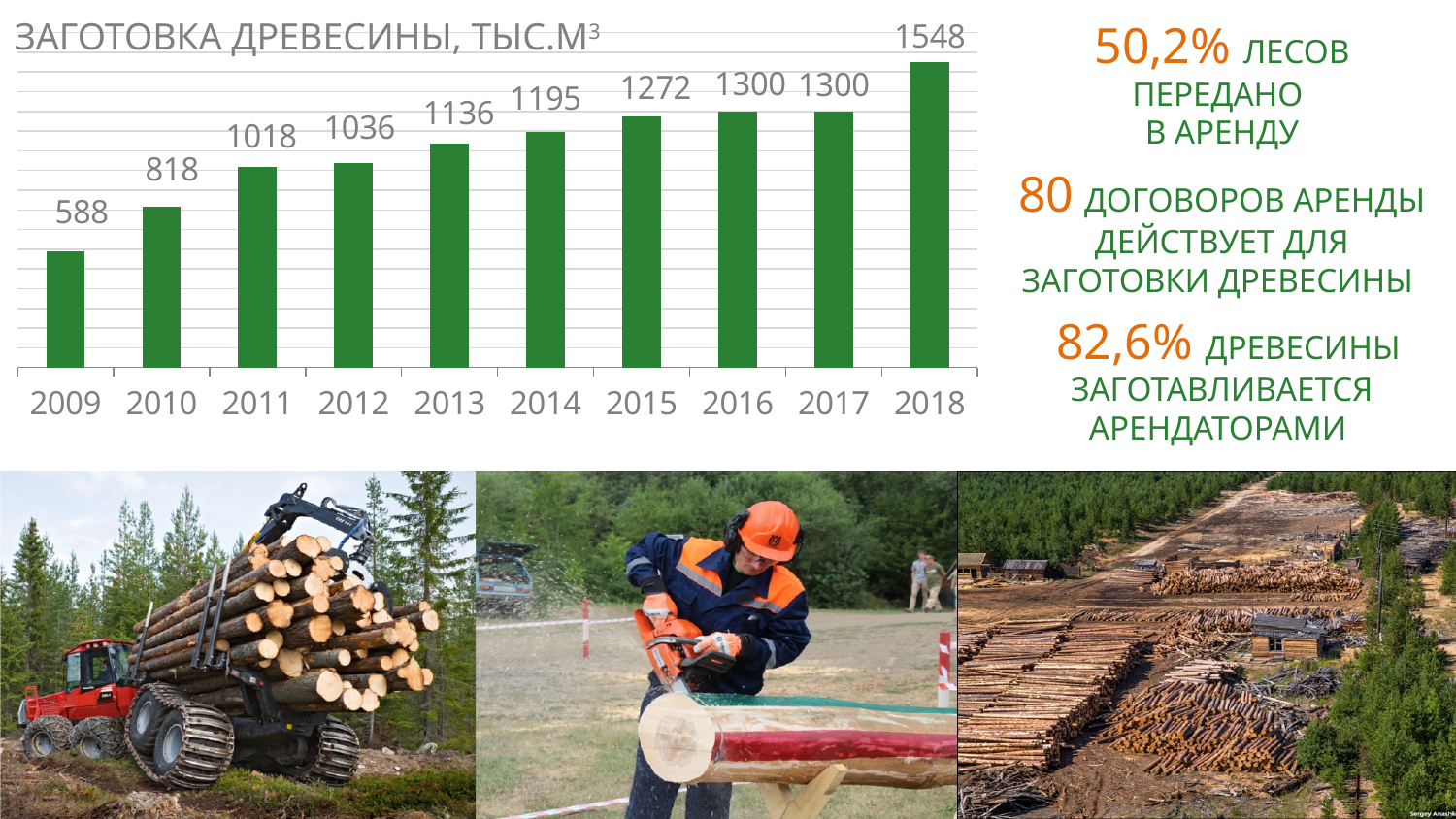
What is the difference between the values for 2010 and 2009? 230 Which is larger, the value for 2013 or the value for 2012? 2013 What is the difference between the values for 2018 and 2017? 248 Which year has the highest value in the chart? 2018 Do the values rise or fall from 2009 to 2018? rise What is the title of the chart? ЗАГОТОВКА ДРЕВЕСИНЫ, ТЫС.М³ What is the value for 2018 in the chart? 1548 What is the value for 2009 in the chart 'ЗАГОТОВКА ДРЕВЕСИНЫ, ТЫС.М³'? 588 What kind of chart is shown on the slide? bar chart Which year has the lowest value in the chart? 2009 What is the value for 2014 in the chart? 1195 How many years are shown on the x axis of the chart? 10